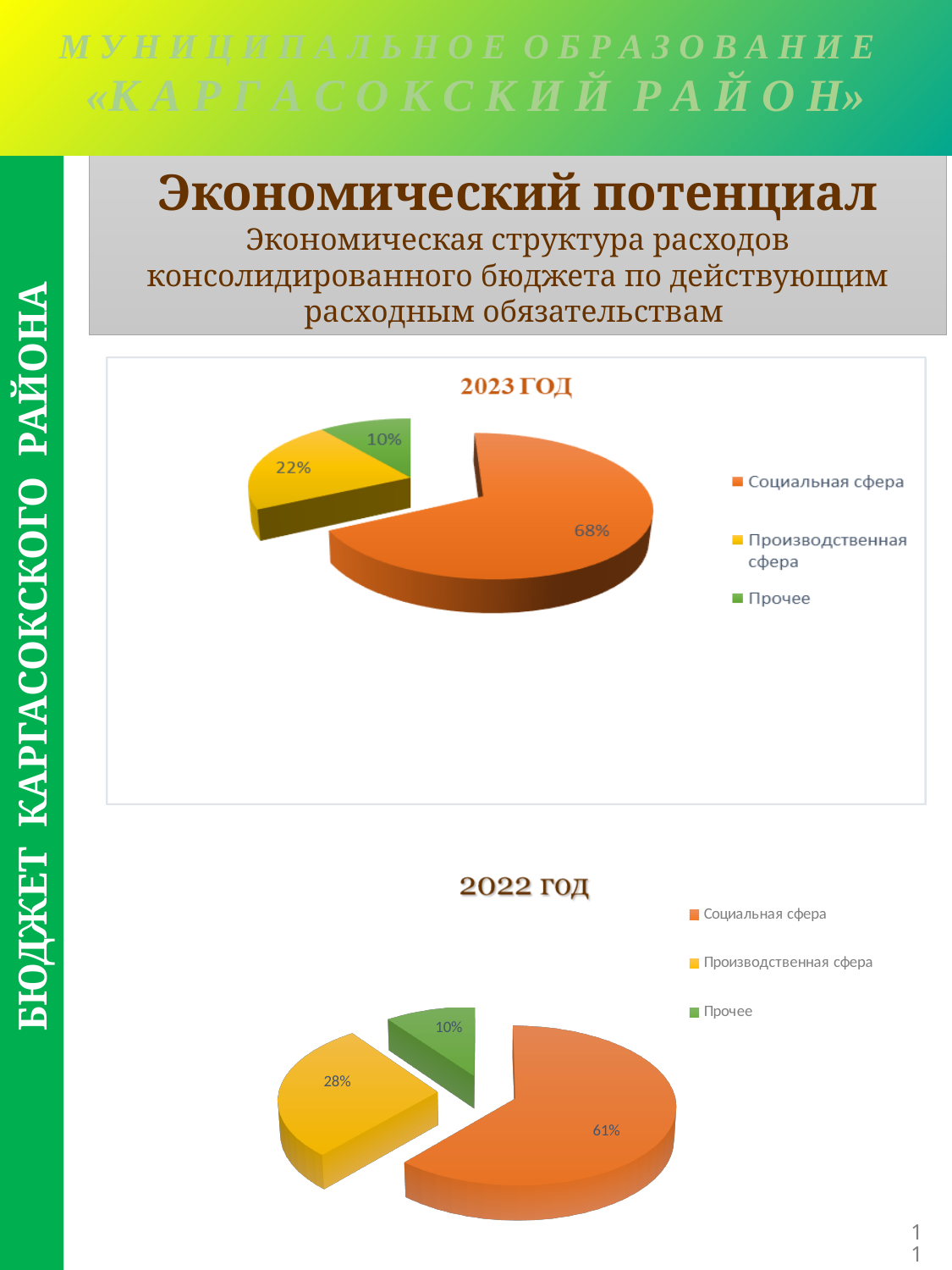
In the "2022 год" chart, what is the difference between the shares of Социальная сфера and Производственная сфера? 33% How many slices does the "2022 год" chart have? 3 In the "2023 ГОД" chart, what share does Социальная сфера have? 68% In the "2022 год" chart, what share does Социальная сфера have? 61% What type of chart is the "2023 ГОД" chart? Pie chart In the "2022 год" chart, what share does Производственная сфера have? 28% In the "2022 год" chart, which category has the largest slice? Социальная сфера In the "2023 ГОД" chart, what colour is the Прочее slice? Green In the "2023 ГОД" chart, what share does Прочее have? 10% Which is larger in the "2023 ГОД" chart: Производственная сфера or Прочее? Производственная сфера In the "2023 ГОД" chart, which category has the smallest slice? Прочее In the "2023 ГОД" chart, what share does Производственная сфера have? 22%